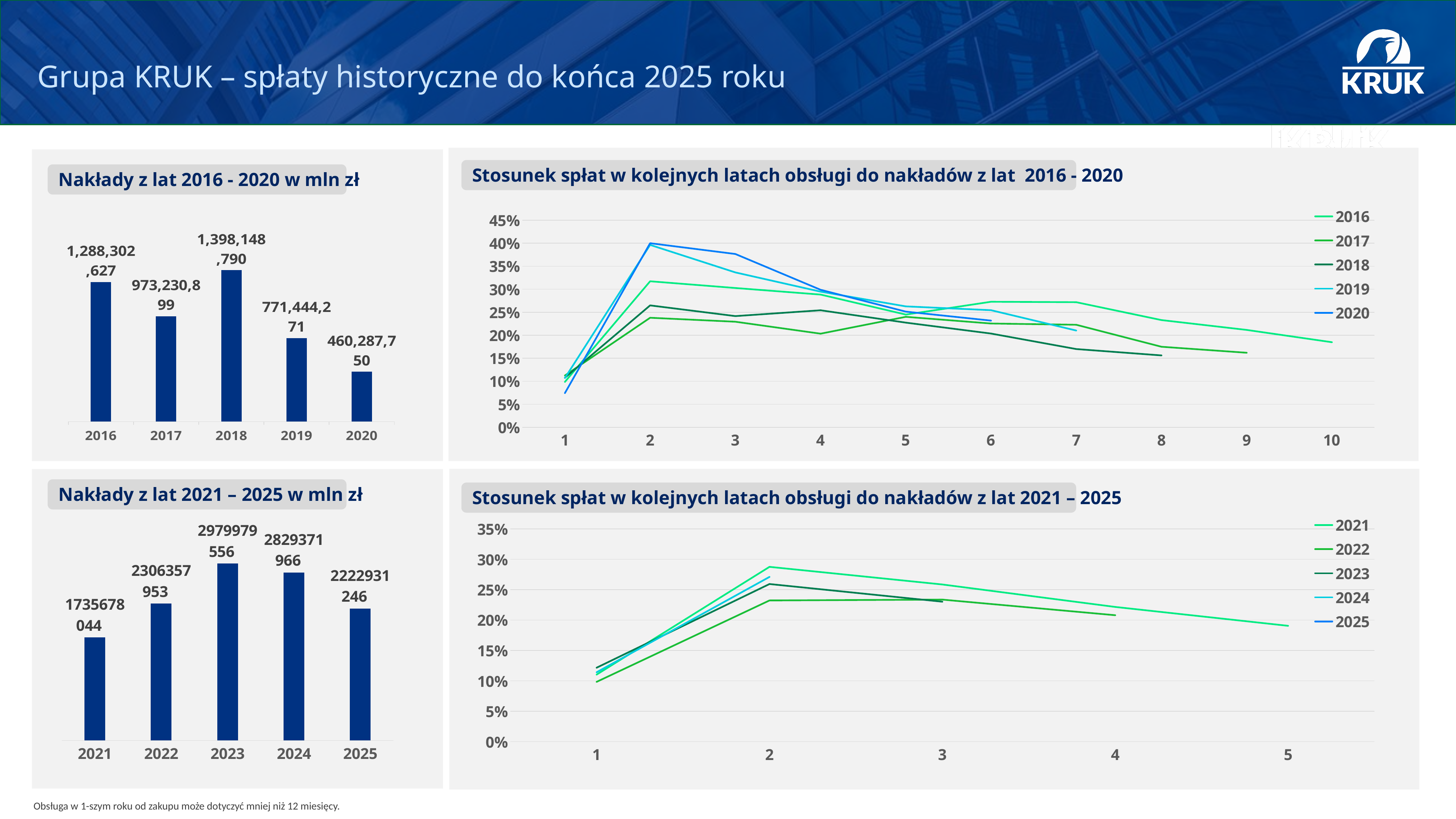
How many series does the legend list in the chart 'Stosunek spłat w kolejnych latach obsługi do nakładów z lat 2016 - 2020'? 5 In the chart 'Nakłady z lat 2016 - 2020 w mln zł', which year has the highest value? 2018 In the chart 'Nakłady z lat 2021 – 2025 w mln zł', which year has the lowest value? 2021 What kind of chart is 'Stosunek spłat w kolejnych latach obsługi do nakładów z lat 2016 - 2020'? line chart In the chart 'Nakłady z lat 2021 – 2025 w mln zł', which is larger, the value for 2022 or for 2025? 2022 In the chart 'Nakłady z lat 2016 - 2020 w mln zł', which year has the lowest value? 2020 In the chart 'Stosunek spłat w kolejnych latach obsługi do nakładów z lat 2021 – 2025', is the value for the 2022 series at year 1 greater or less than 15%? less In the chart 'Nakłady z lat 2016 - 2020 w mln zł', what is the value for 2018? 1,398,148,790 In the chart 'Nakłady z lat 2021 – 2025 w mln zł', what is the value for 2023? 2979979556 In the chart 'Stosunek spłat w kolejnych latach obsługi do nakładów z lat 2016 - 2020', is the value for the 2020 series at year 2 greater or less than 35%? greater In the chart 'Nakłady z lat 2016 - 2020 w mln zł', what is the difference between the values for 2016 and 2017? 315,071,728 In the chart 'Nakłady z lat 2021 – 2025 w mln zł', how many bars are shown? 5